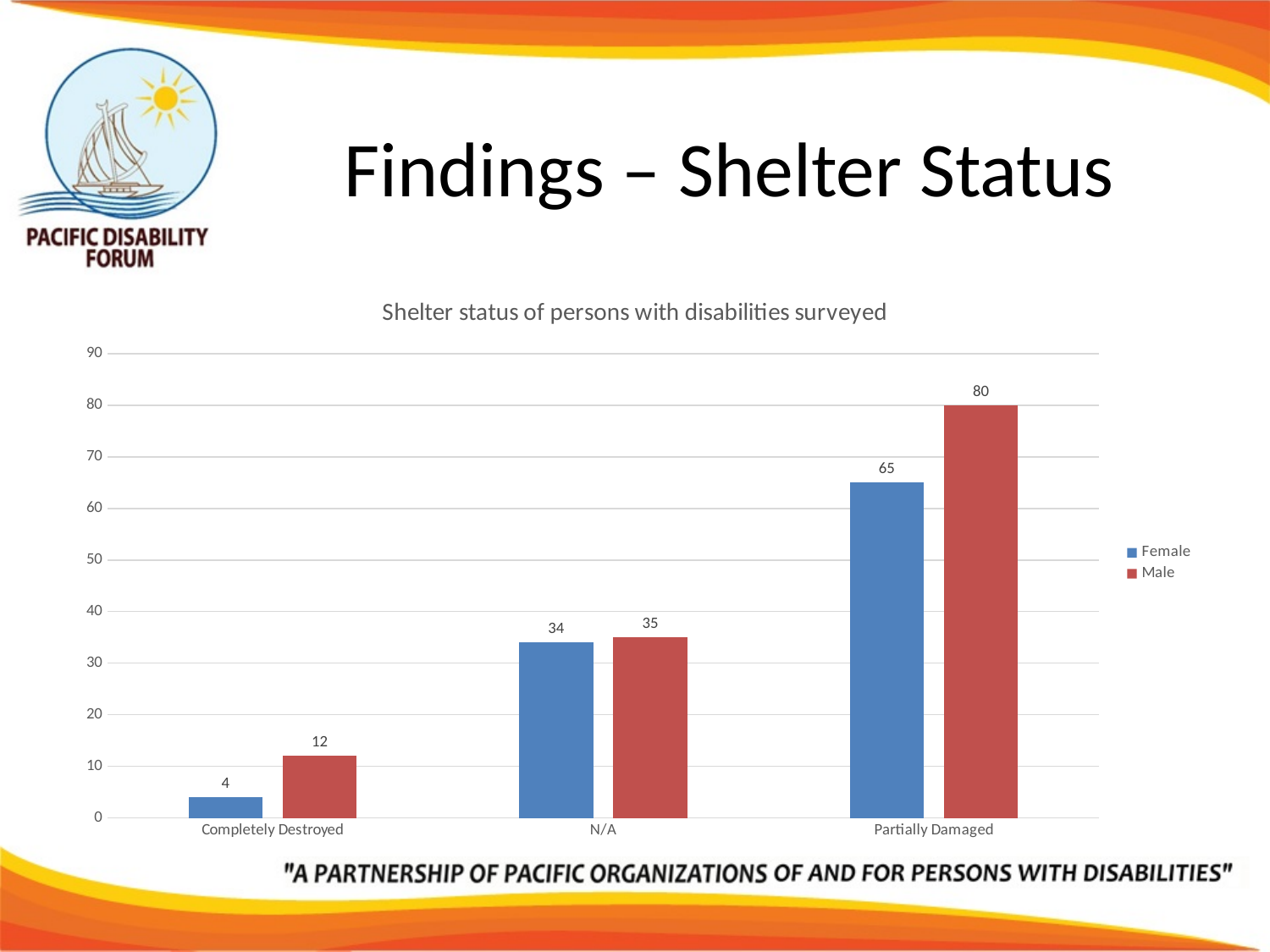
What is the Female value for N/A? 34 How many categories are shown on the x axis? 3 What is the Male value for Completely Destroyed? 12 Which is larger for Completely Destroyed, the Female value or the Male value? Male How many series does the legend list? 2 What kind of chart is shown on the slide? Bar chart Which category has the highest Male value? Partially Damaged What is the difference between the Male and Female values for Completely Destroyed? 8 What is the Female value for Partially Damaged? 65 What is the title of the chart? Shelter status of persons with disabilities surveyed What is the difference between the Male and Female values for Partially Damaged? 15 Which category has the lowest Female value? Completely Destroyed